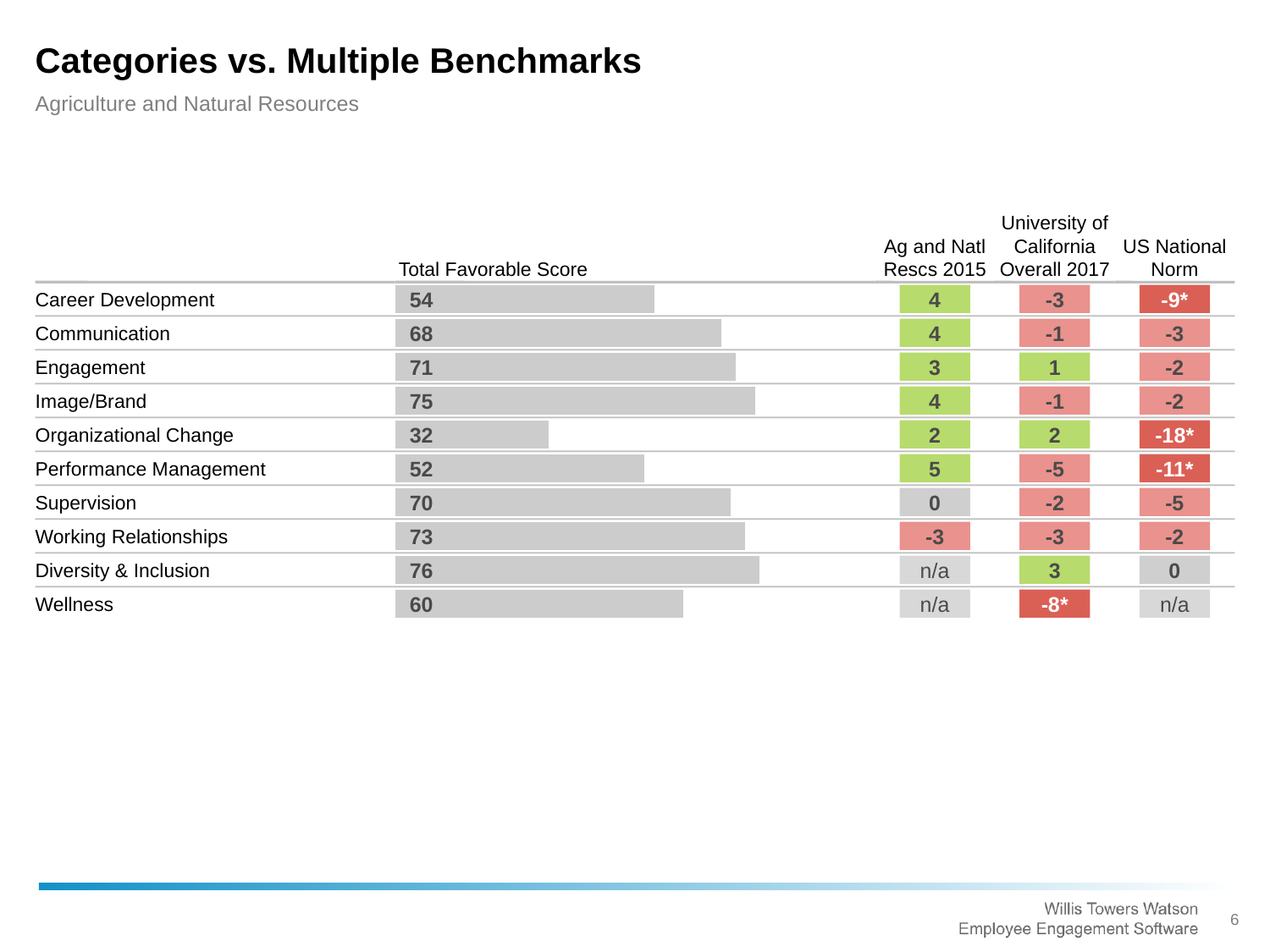
What is the Total Favorable Score for Wellness? 60 Which category has the highest Total Favorable Score? Diversity & Inclusion What is the Total Favorable Score for Career Development? 54 What is the difference between the Total Favorable Scores for Image/Brand and Career Development? 21 How many benchmark comparison columns are shown to the right of the Total Favorable Score bars? 3 What is the difference versus University of California Overall 2017 for Performance Management? -5 How many categories are shown in the Total Favorable Score chart? 10 What is the Total Favorable Score for Organizational Change? 32 What kind of chart is used to show the Total Favorable Score? Bar chart Which has a higher Total Favorable Score, Communication or Supervision? Supervision What is the difference versus the US National Norm for Organizational Change? -18* Which category has the lowest Total Favorable Score? Organizational Change